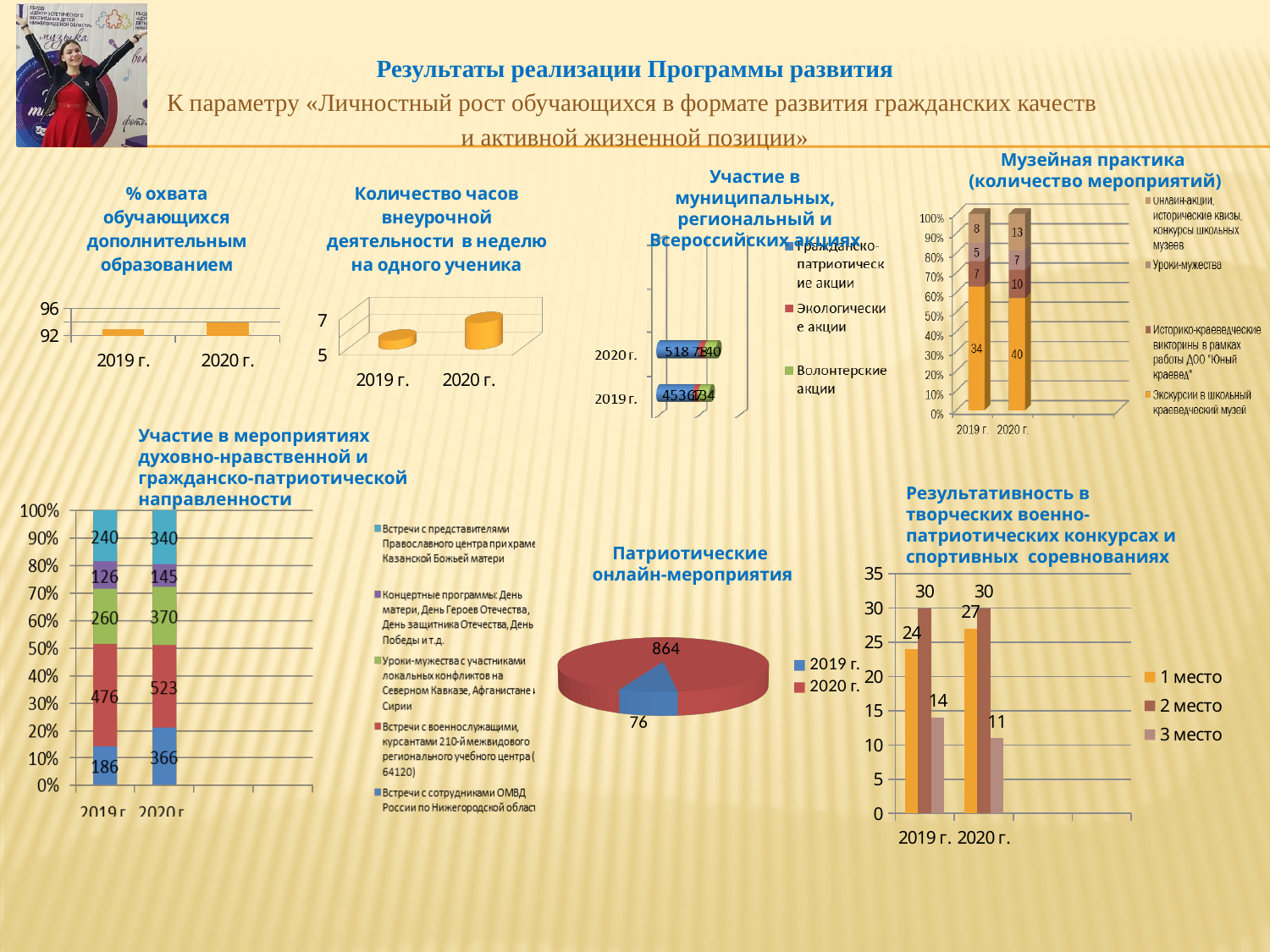
In the chart 'Участие в мероприятиях духовно-нравственной и гражданско-патриотической направленности', what is the value of the largest segment in the 2019 г. bar? 476 In the chart '% охвата обучающихся дополнительным образованием', which year has the larger value, 2019 г. or 2020 г.? 2020 г. In the pie chart 'Патриотические онлайн-мероприятия', what is the value for 2020 г.? 864 In the chart 'Музейная практика (количество мероприятий)', what is the value of the bottom (orange) segment for 2020 г.? 40 In the chart 'Музейная практика (количество мероприятий)', what is the total of the 2019 г. stacked bar? 54 In the chart 'Результативность в творческих военно-патриотических конкурсах и спортивных соревнованиях', what is the value for '3 место' in 2019 г.? 14 What kind of chart is 'Патриотические онлайн-мероприятия'? Pie chart In the chart 'Участие в мероприятиях духовно-нравственной и гражданско-патриотической направленности', what is the total of the 2020 г. stacked bar? 1744 In the chart 'Результативность в творческих военно-патриотических конкурсах и спортивных соревнованиях', what is the difference between '1 место' in 2020 г. and '1 место' in 2019 г.? 3 How many series does the legend list in the chart 'Результативность в творческих военно-патриотических конкурсах и спортивных соревнованиях'? 3 In the chart 'Результативность в творческих военно-патриотических конкурсах и спортивных соревнованиях', what is the value for '1 место' in 2020 г.? 27 In the pie chart 'Патриотические онлайн-мероприятия', what is the difference between the 2020 г. and 2019 г. values? 788